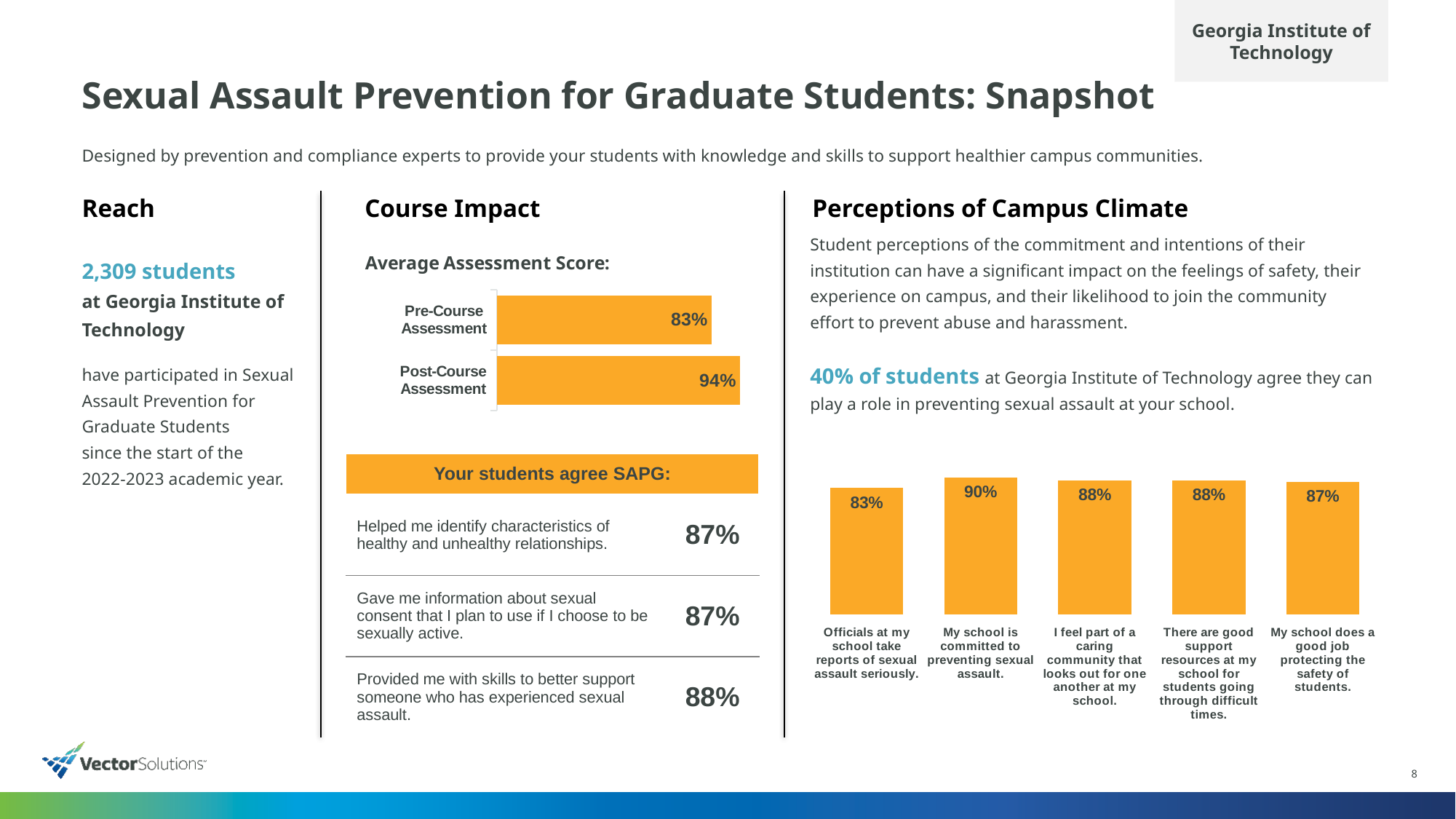
How many bars are in the Average Assessment Score chart? 2 What kind of chart is the Average Assessment Score chart? Bar chart In the Average Assessment Score chart, what is the difference between the Post-Course and Pre-Course Assessment values? 11% How many bars are in the Perceptions of Campus Climate chart? 5 In the Perceptions of Campus Climate chart, which category has the lowest value? Officials at my school take reports of sexual assault seriously. In the Average Assessment Score chart, which is larger, the Pre-Course or the Post-Course Assessment? Post-Course Assessment In the Perceptions of Campus Climate chart, what is the value for "Officials at my school take reports of sexual assault seriously."? 83% In the Perceptions of Campus Climate chart, what is the difference between "My school is committed to preventing sexual assault." and "My school does a good job protecting the safety of students."? 3% In the Perceptions of Campus Climate chart, what is the value for "My school is committed to preventing sexual assault."? 90% In the Average Assessment Score chart, what is the value for the Pre-Course Assessment? 83% In the Average Assessment Score chart, what is the value for the Post-Course Assessment? 94% In the Perceptions of Campus Climate chart, which category has the highest value? My school is committed to preventing sexual assault.